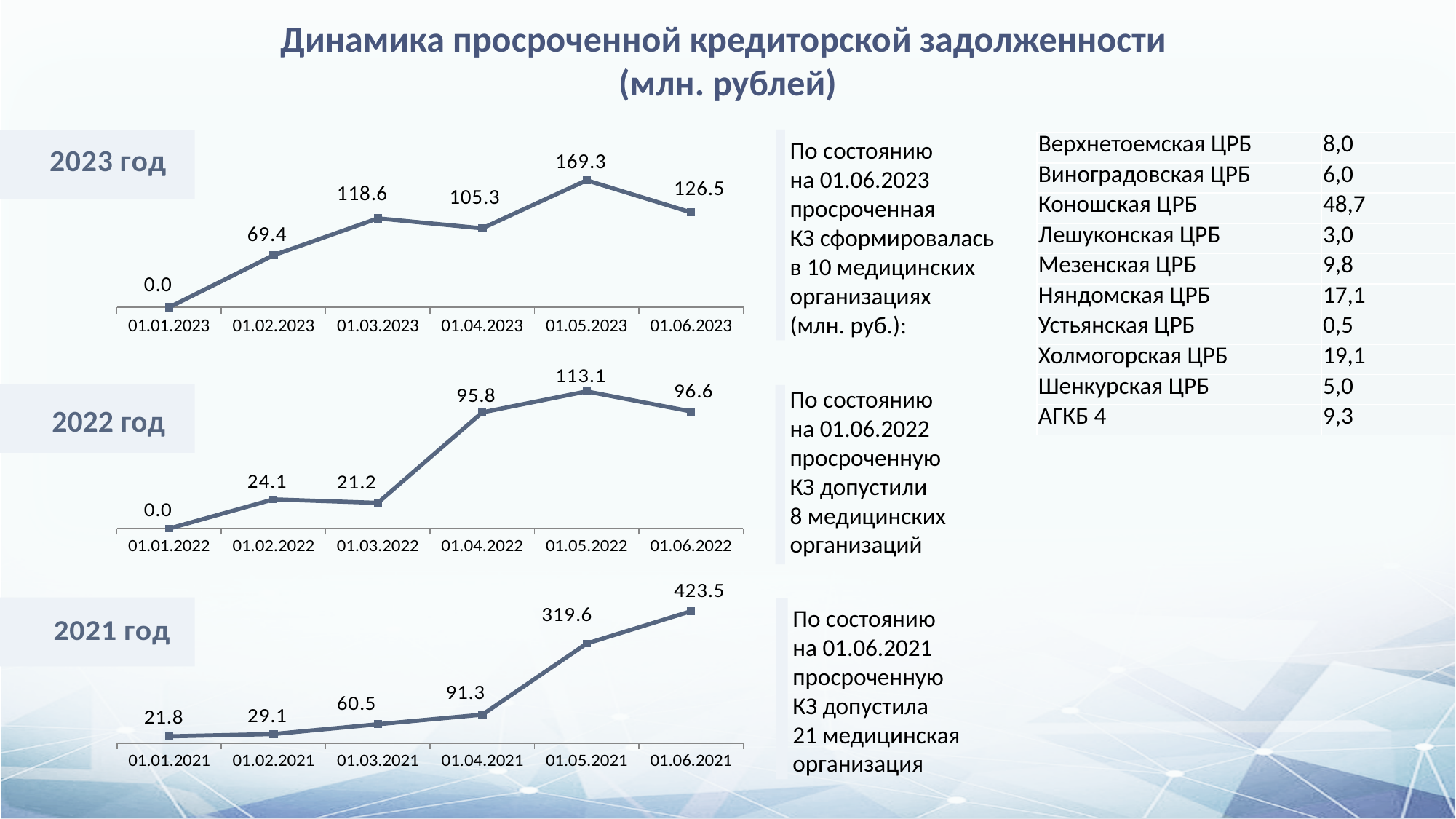
In the 2021 год chart, do the values rise or fall from 01.01.2021 to 01.06.2021? rise In the 2022 год chart, what is the value for 01.04.2022? 95.8 In the 2023 год chart, what is the difference between the values for 01.05.2023 and 01.06.2023? 42.8 How many data points are plotted in the 2023 год chart? 6 In the 2023 год chart, what is the value for 01.05.2023? 169.3 In the 2021 год chart, what is the value for 01.06.2021? 423.5 In the 2021 год chart, which date has the lowest value? 01.01.2021 In the 2022 год chart, which is larger, the value for 01.02.2022 or 01.03.2022? 01.02.2022 What type of chart is the 2022 год chart? line chart In the 2023 год chart, which date has the highest value? 01.05.2023 In the 2021 год chart, what is the difference between the values for 01.06.2021 and 01.05.2021? 103.9 In the 2022 год chart, which date has the highest value? 01.05.2022